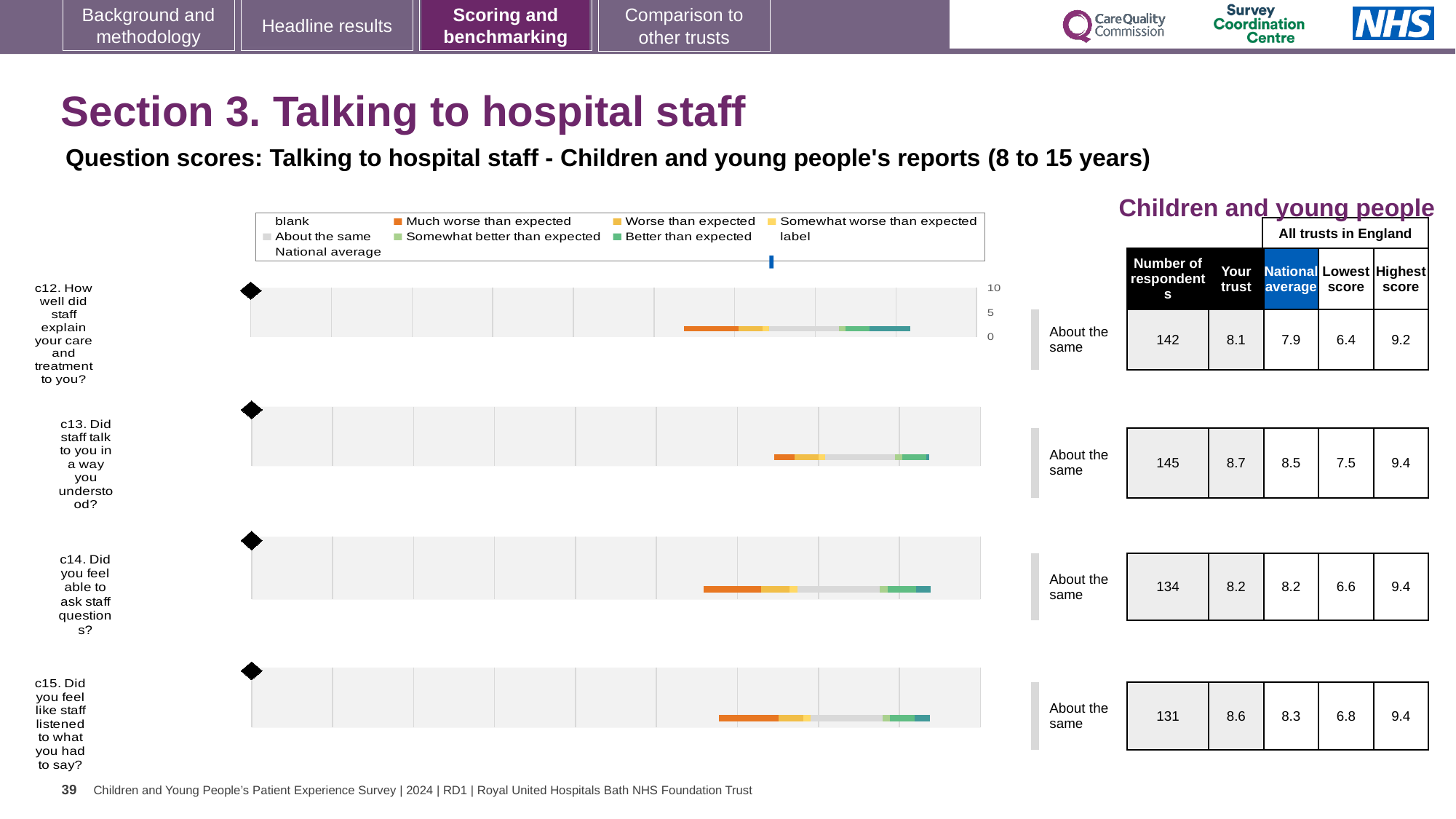
For c15, which is larger: the 'Your trust' score or the national average? Your trust For c12, what is the difference between the 'Your trust' score and the national average? 0.2 What is the lowest score across all trusts in England for c15 (Did you feel like staff listened to what you had to say?)? 6.8 What type of chart is used to show the question scores for c12 to c15? Bar chart What is the national average score for c13 (Did staff talk to you in a way you understood?)? 8.5 What is the number of respondents for c14 (Did you feel able to ask staff questions?)? 134 For c13, what is the difference between the highest score and the lowest score across all trusts in England? 1.9 How many questions (c12 to c15) are plotted on the slide? 4 What benchmark category is shown for c14 (Did you feel able to ask staff questions?)? About the same What is the 'Your trust' score for c12 (How well did staff explain your care and treatment to you?)? 8.1 Which question has the highest 'Your trust' score? c13. Did staff talk to you in a way you understood? Which question has the lowest 'Your trust' score? c12. How well did staff explain your care and treatment to you?